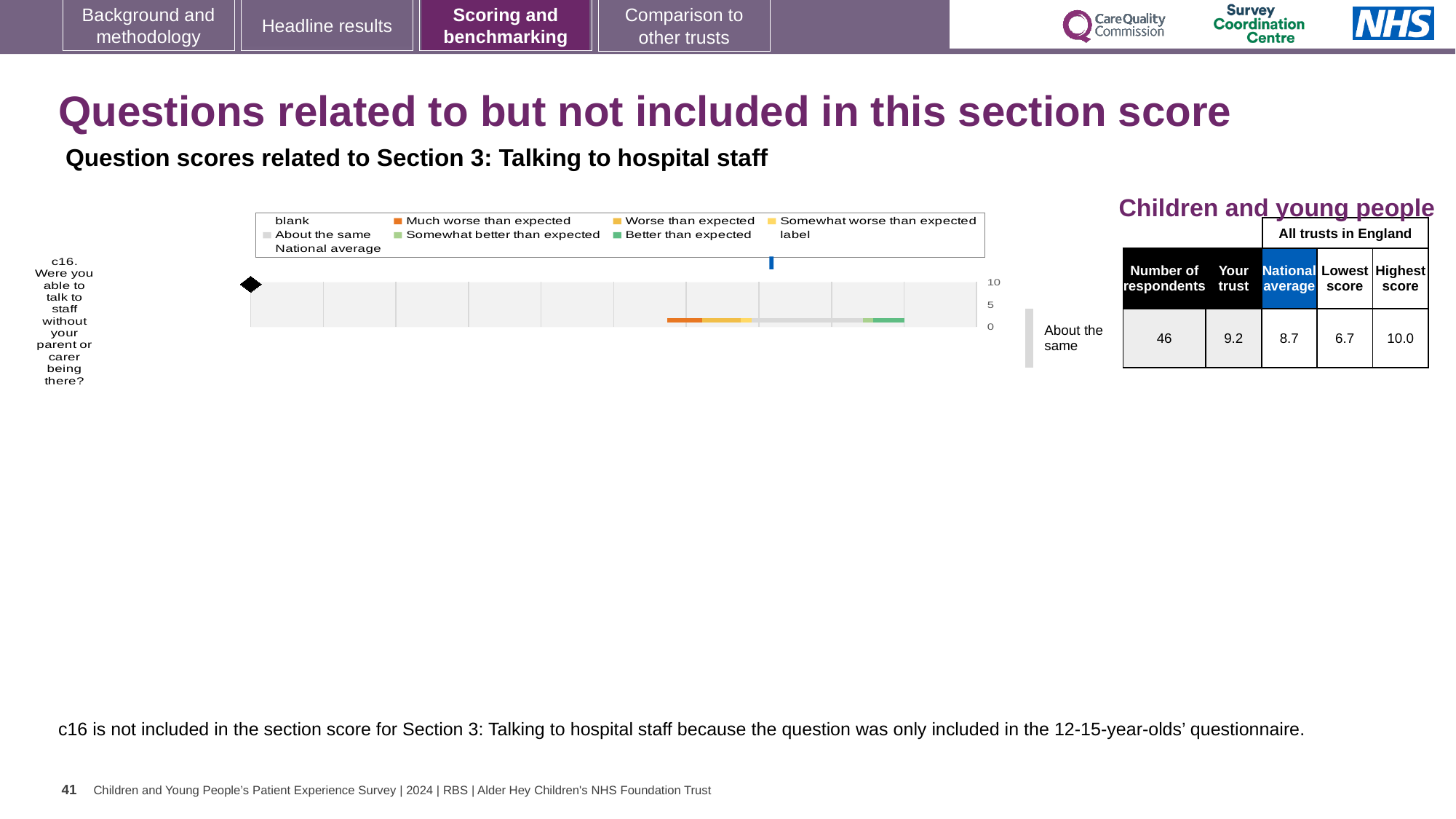
How many respondents answered c16? 46 What is the highest score among all trusts in England for c16? 10.0 What is the national average score for c16? 8.7 How many questions (categories) are plotted in the chart? 1 Which is larger for c16, the 'Your trust' score or the national average? Your trust What kind of chart is shown for question c16? bar chart What is the highest value shown on the chart's numeric axis? 10 What is the difference between the 'Your trust' score and the national average for c16? 0.5 What is the lowest score among all trusts in England for c16? 6.7 Which question is plotted in the chart? c16. Were you able to talk to staff without your parent or carer being there? What is the difference between the highest and lowest trust scores for c16? 3.3 What is the 'Your trust' score for c16 in the Children and young people table? 9.2